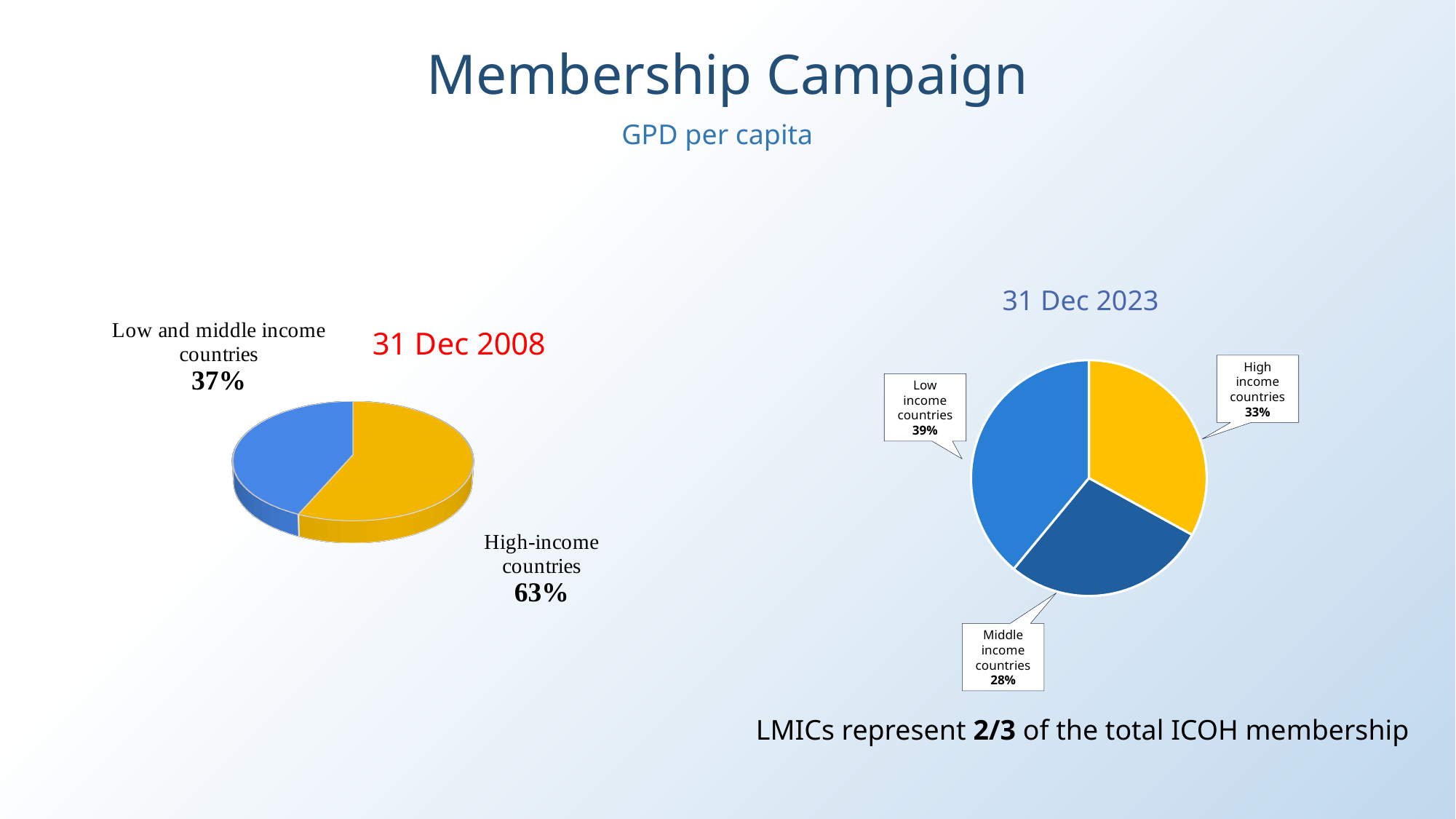
In the 31 Dec 2023 pie chart, which category has the smallest share? Middle income countries What type of chart is the 31 Dec 2008 chart? Pie chart In the 31 Dec 2008 pie chart, what share do High-income countries have? 63% In the 31 Dec 2023 pie chart, what share do Low income countries have? 39% How many slices does the 31 Dec 2023 pie chart have? 3 In the 31 Dec 2023 pie chart, what colour is the High income countries slice? Yellow In the 31 Dec 2023 pie chart, which is larger: the share of High income countries or Middle income countries? High income countries In the 31 Dec 2008 pie chart, what is the difference in percentage points between High-income countries and Low and middle income countries? 26 In the 31 Dec 2008 pie chart, what share do Low and middle income countries have? 37% In the 31 Dec 2023 pie chart, which category has the largest share? Low income countries In the 31 Dec 2023 pie chart, what share do High income countries have? 33% In the 31 Dec 2023 pie chart, what share do Middle income countries have? 28%